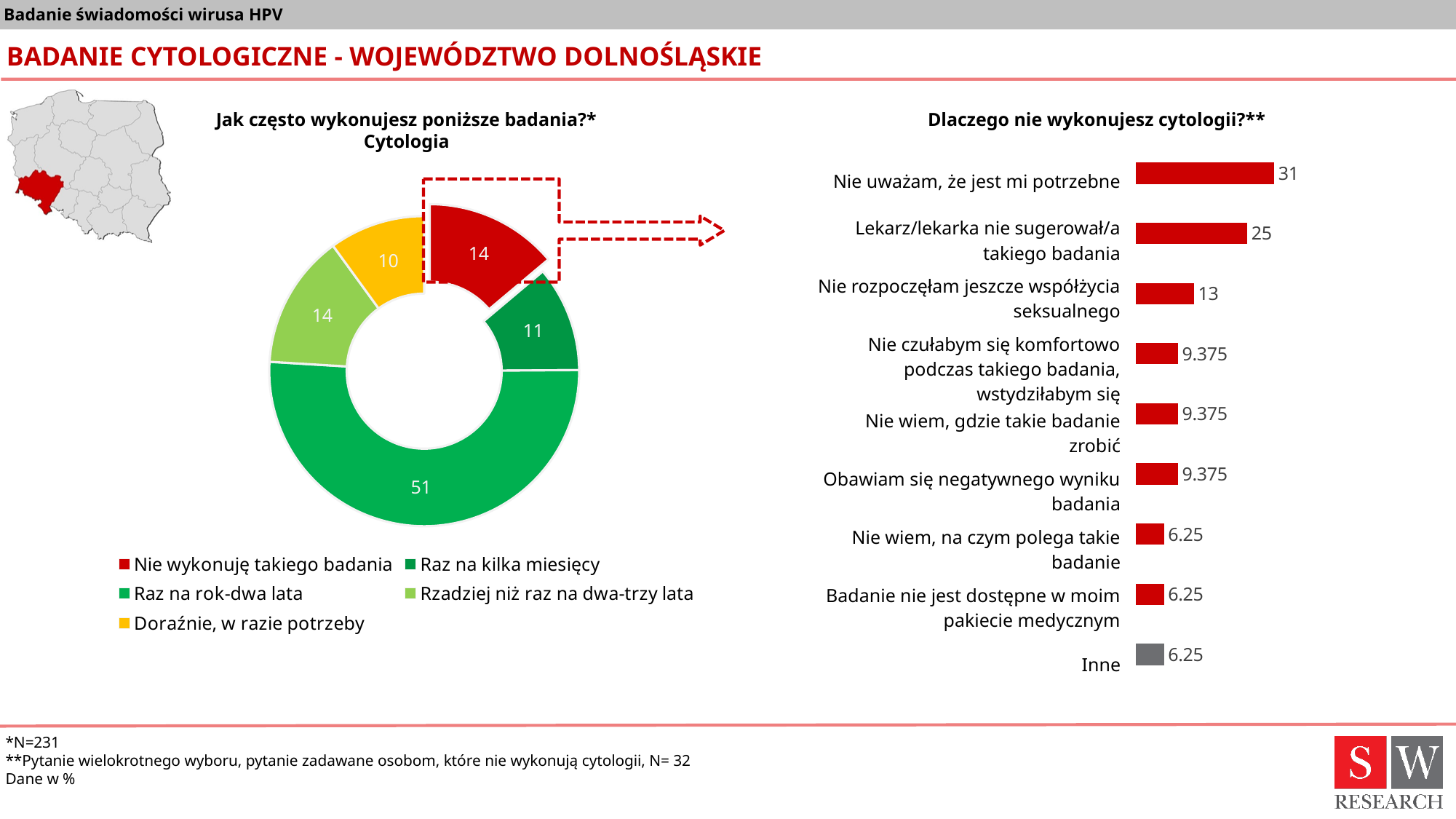
What kind of chart is 'Jak często wykonujesz poniższe badania?* Cytologia'? Pie (donut) chart In the chart 'Jak często wykonujesz poniższe badania?* Cytologia', which category has the smallest share? Doraźnie, w razie potrzeby In the chart 'Dlaczego nie wykonujesz cytologii?**', what is the value for 'Lekarz/lekarka nie sugerował/a takiego badania'? 25 In the chart 'Dlaczego nie wykonujesz cytologii?**', which category has the highest value? Nie uważam, że jest mi potrzebne In the chart 'Jak często wykonujesz poniższe badania?* Cytologia', which category has the largest share? Raz na rok-dwa lata What kind of chart is 'Dlaczego nie wykonujesz cytologii?**'? Bar chart In the chart 'Jak często wykonujesz poniższe badania?* Cytologia', what is the value for 'Doraźnie, w razie potrzeby'? 10 In the chart 'Dlaczego nie wykonujesz cytologii?**', how many categories are shown? 9 In the chart 'Dlaczego nie wykonujesz cytologii?**', what is the difference between 'Nie uważam, że jest mi potrzebne' and 'Lekarz/lekarka nie sugerował/a takiego badania'? 6 In the chart 'Dlaczego nie wykonujesz cytologii?**', what is the value for 'Nie rozpoczęłam jeszcze współżycia seksualnego'? 13 In the chart 'Jak często wykonujesz poniższe badania?* Cytologia', how many categories does the legend list? 5 In the chart 'Jak często wykonujesz poniższe badania?* Cytologia', what is the value for 'Raz na rok-dwa lata'? 51